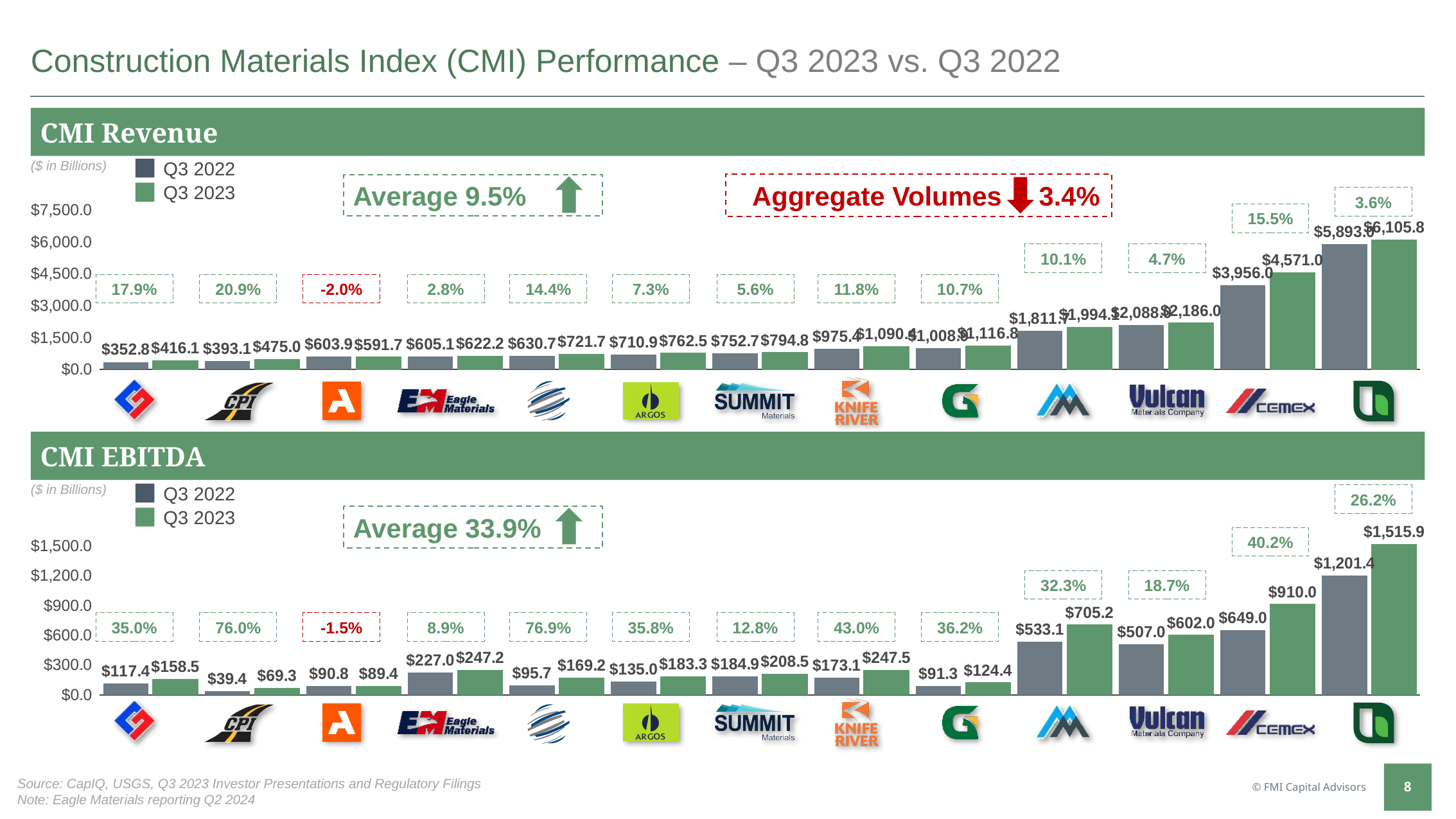
In the CMI EBITDA chart, what percentage change is shown above the Knife River bars? 43.0% How many companies are shown in the CMI Revenue chart? 13 How many series does the legend of the CMI EBITDA chart list? 2 What average percentage change is highlighted in the CMI EBITDA chart? Average 33.9% In the CMI Revenue chart, what percentage change is shown above the CPI bars? 20.9% In the CMI Revenue chart, which is larger: Argos' Q3 2023 revenue or Eagle Materials' Q3 2023 revenue? Argos In the CMI EBITDA chart, what is the Q3 2023 EBITDA for Vulcan Materials Company? $602.0 In the CMI EBITDA chart, which company has the lowest Q3 2022 EBITDA? CPI In the CMI Revenue chart, what is the Q3 2023 revenue for Cemex? $4,571.0 In the CMI EBITDA chart, what is the difference between Cemex's Q3 2023 and Q3 2022 EBITDA? $261.0 In the CMI Revenue chart, what is the Q3 2022 revenue for Knife River? $975.4 In the CMI Revenue chart, what is the difference between Summit Materials' Q3 2023 and Q3 2022 revenue? $42.1